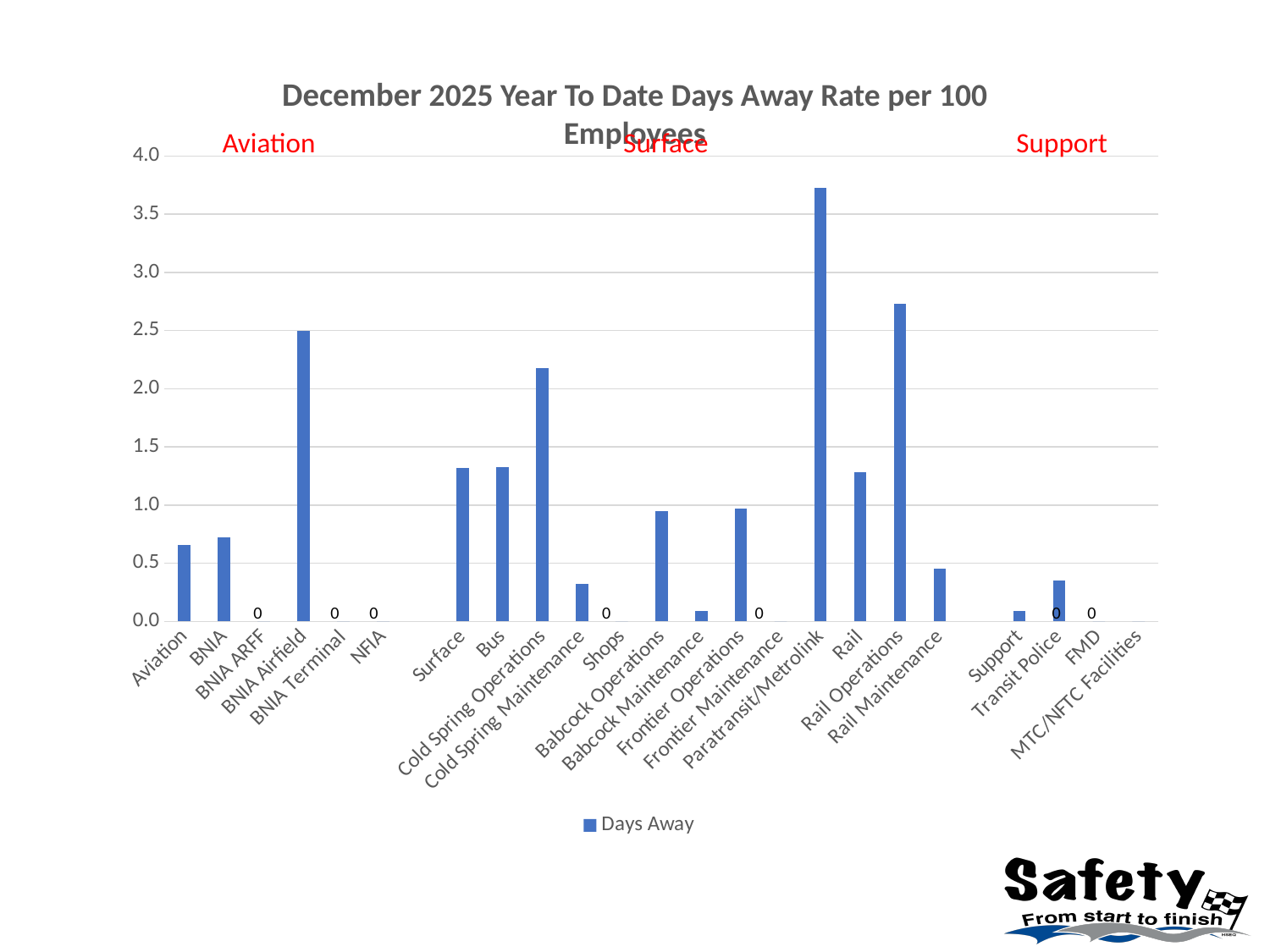
Which has a higher Days Away rate, BNIA Airfield or Cold Spring Operations? BNIA Airfield What is the Days Away value for BNIA ARFF? 0 Is the value for Babcock Maintenance greater or less than 0.5? less What type of chart is shown on the slide? Bar chart What is the Days Away value for Frontier Maintenance? 0 Is the value for Paratransit/Metrolink greater or less than 3.5? greater What is the title of the chart? December 2025 Year To Date Days Away Rate per 100 Employees Which category has the highest Days Away rate? Paratransit/Metrolink How many series does the legend list? 1 Is the value for Rail Operations greater or less than 2.5? greater What is the Days Away value for Shops? 0 What are the three red group labels shown above the chart? Aviation, Surface, Support